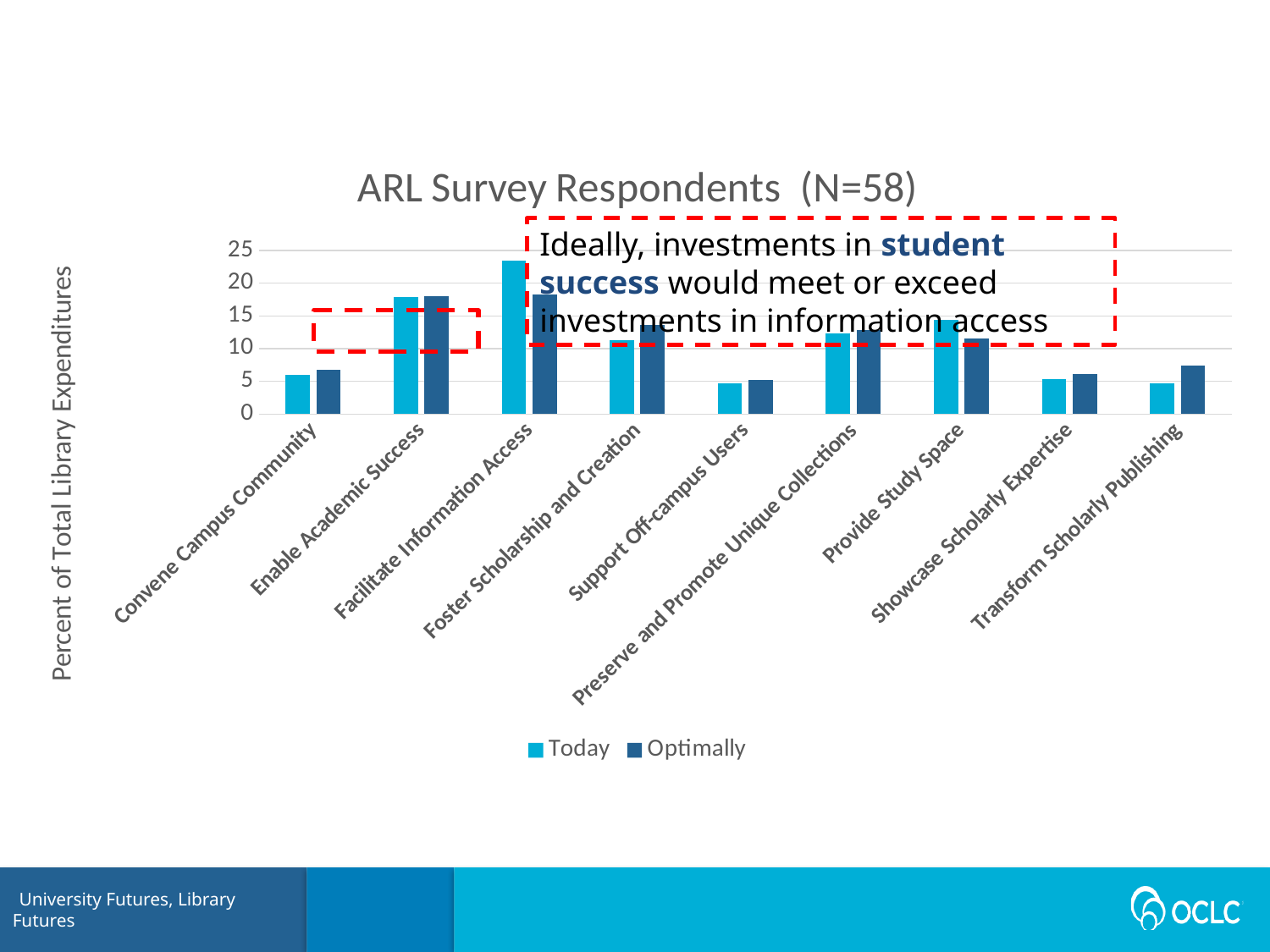
Is the Today value for Facilitate Information Access greater or less than 20? greater Is the Today value for Convene Campus Community greater or less than 10? less What is the title of the chart? ARL Survey Respondents (N=58) How many series does the legend list? 2 Which category has the highest value for the Today series? Facilitate Information Access Is the Today value for Enable Academic Success greater or less than 15? greater How many categories are shown on the x axis? 9 For Facilitate Information Access, which series has the larger value, Today or Optimally? Today For Transform Scholarly Publishing, which series has the larger value, Today or Optimally? Optimally What is the label on the y axis? Percent of Total Library Expenditures What kind of chart is shown on the slide? bar chart